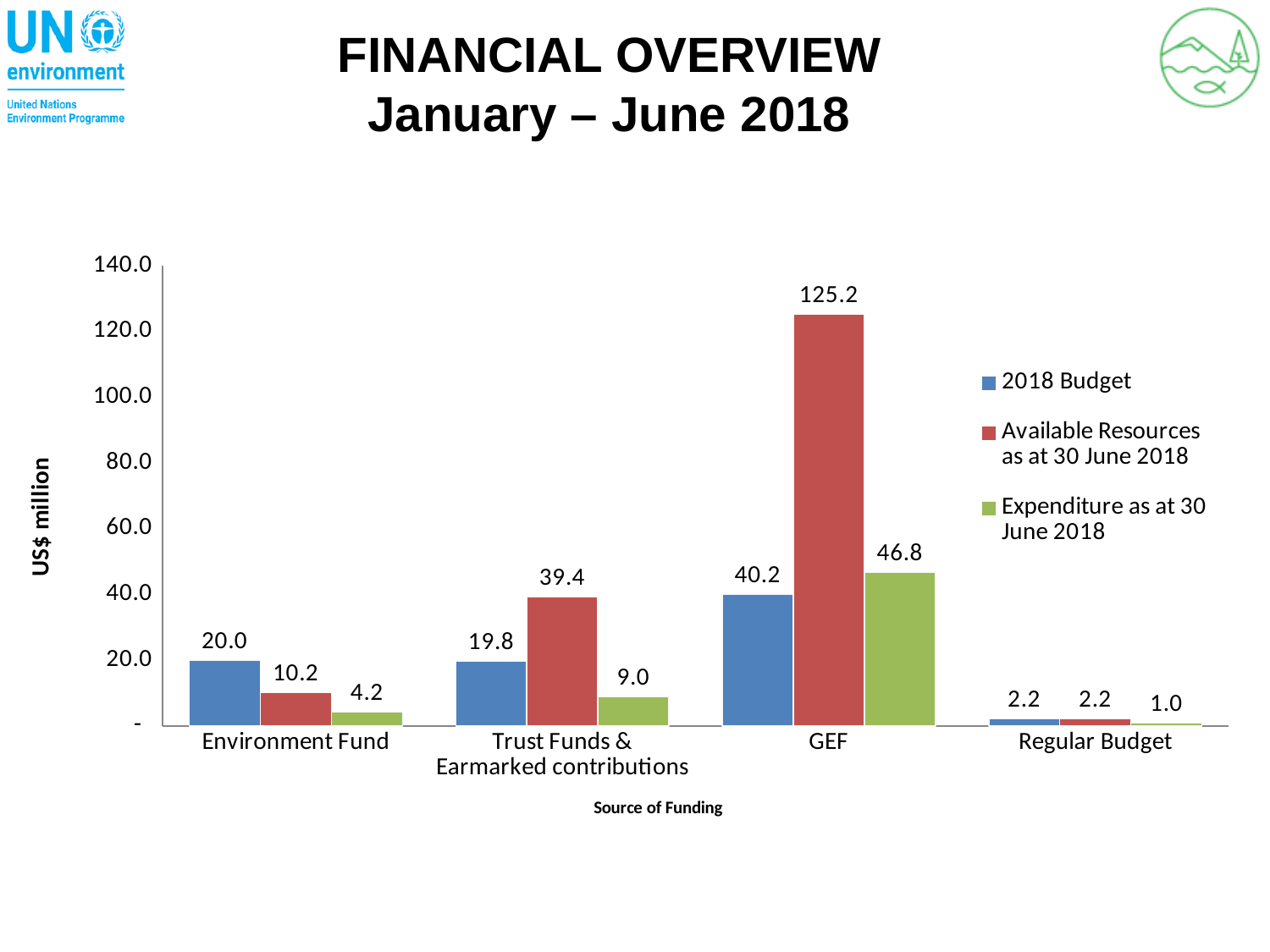
How many sources of funding are shown on the x axis? 4 How many series does the legend list? 3 What is the Expenditure as at 30 June 2018 for Trust Funds & Earmarked contributions? 9.0 What is the difference between the Available Resources and the Expenditure as at 30 June 2018 for GEF? 78.4 What kind of chart is shown on the slide? Bar chart Which source of funding has the lowest Expenditure as at 30 June 2018? Regular Budget Which is larger for the Environment Fund: the 2018 Budget or the Available Resources as at 30 June 2018? 2018 Budget What is the label of the y axis? US$ million What is the 2018 Budget value for the Environment Fund? 20.0 Is the Available Resources value for GEF greater or less than 120.0? greater Which source of funding has the highest Available Resources as at 30 June 2018? GEF What are the Available Resources as at 30 June 2018 for GEF? 125.2